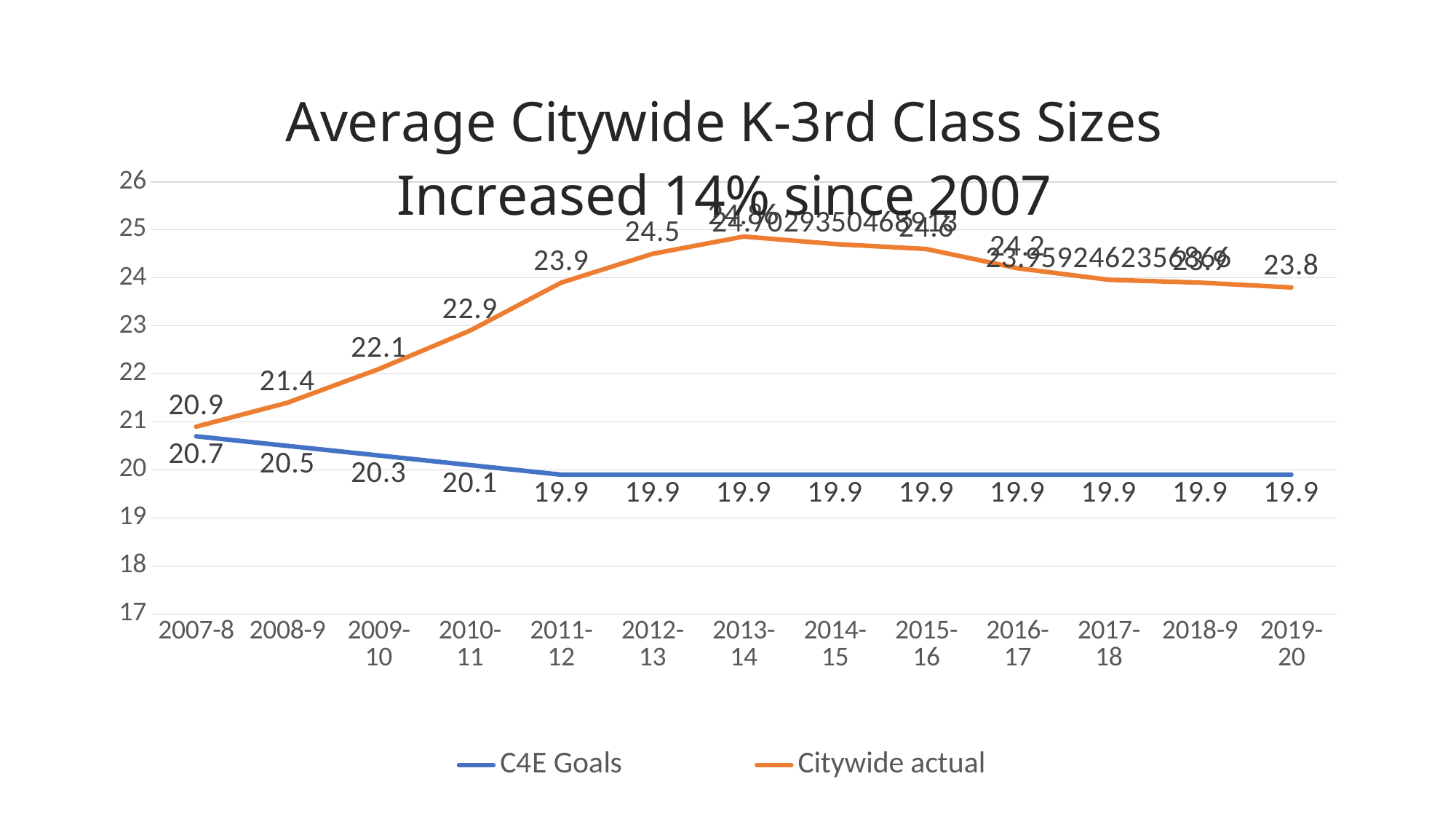
What is the difference between the Citywide actual and C4E Goals values in 2011-12? 4.0 What is the Citywide actual value for 2019-20? 23.8 In which school year is the Citywide actual value lowest? 2007-8 How many school years are plotted along the x axis? 13 Does the C4E Goals line rise or fall from 2007-8 to 2011-12? fall What is the Citywide actual value for 2012-13? 24.5 Which is larger in 2008-9, the Citywide actual value or the C4E Goals value? Citywide actual What kind of chart is shown on the slide? line chart How many series does the legend list? 2 What is the C4E Goals value for 2009-10? 20.3 In which school year is the C4E Goals value highest? 2007-8 Is the Citywide actual value for 2013-14 greater or less than 24? greater